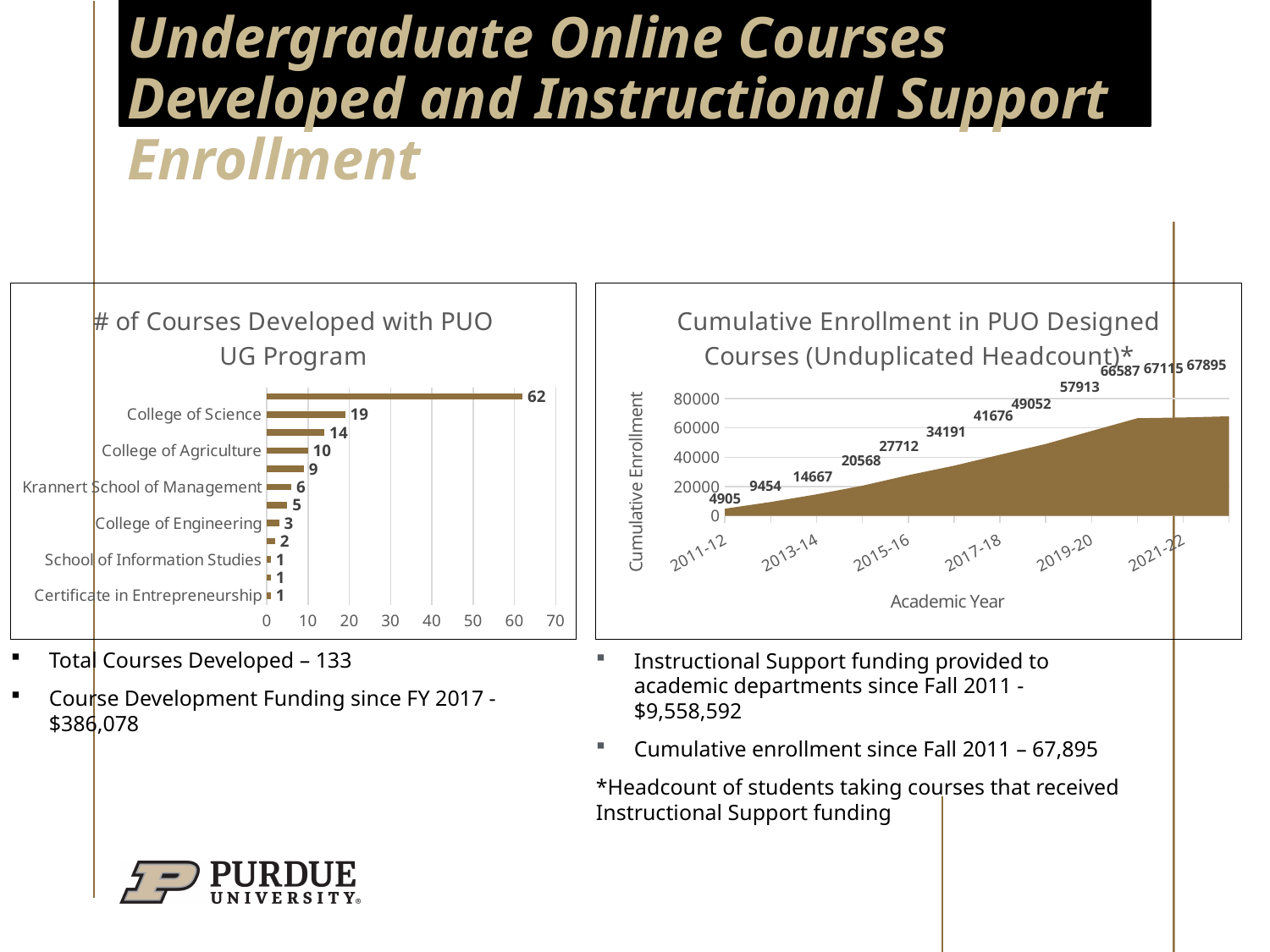
In the 'Cumulative Enrollment in PUO Designed Courses' chart, what is the cumulative enrollment for 2019-20? 57913 In the 'Cumulative Enrollment in PUO Designed Courses' chart, how many data points are plotted? 12 In the '# of Courses Developed with PUO UG Program' chart, how many more courses did the College of Science develop than the College of Agriculture? 9 What kind of chart is 'Cumulative Enrollment in PUO Designed Courses (Unduplicated Headcount)'? area chart In the 'Cumulative Enrollment in PUO Designed Courses' chart, do the values rise or fall across the academic years? rise In the '# of Courses Developed with PUO UG Program' chart, what is the value for the Krannert School of Management? 6 In the '# of Courses Developed with PUO UG Program' chart, which has the larger value: College of Engineering or Krannert School of Management? Krannert School of Management In the '# of Courses Developed with PUO UG Program' chart, what is the value for the College of Agriculture? 10 In the '# of Courses Developed with PUO UG Program' chart, what is the largest value shown on any bar? 62 What kind of chart is '# of Courses Developed with PUO UG Program'? bar chart In the '# of Courses Developed with PUO UG Program' chart, how many courses were developed by the College of Science? 19 In the 'Cumulative Enrollment in PUO Designed Courses' chart, what is the cumulative enrollment for 2011-12? 4905